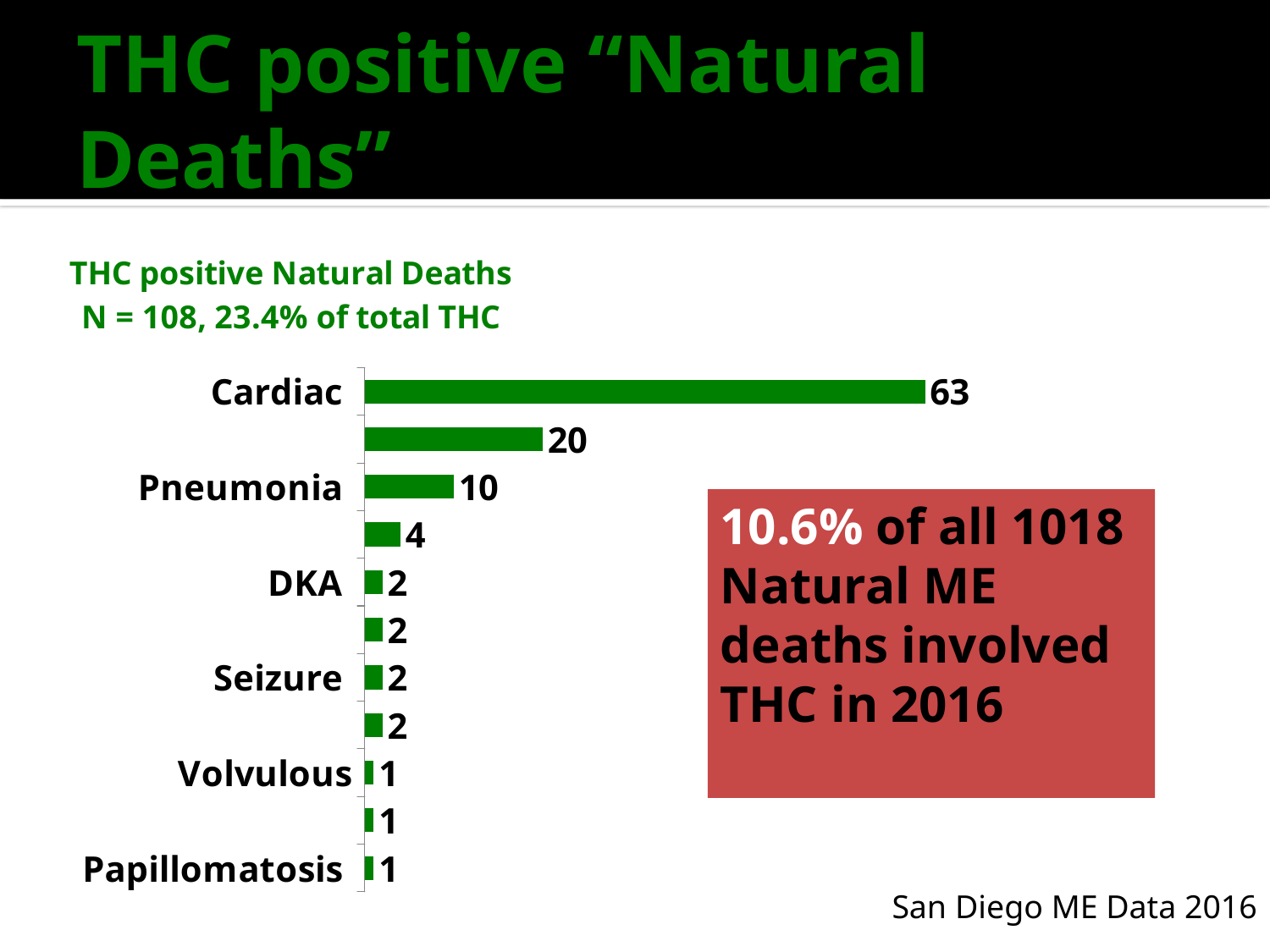
What is the title of the chart? THC positive Natural Deaths N = 108, 23.4% of total THC Which is larger, the value for Pneumonia or the value for DKA? Pneumonia What is the value for Seizure? 2 How many bars are plotted in the chart? 11 What is the difference between the values for Cardiac and Pneumonia? 53 What kind of chart is shown on the slide? Bar chart What is the value for Volvulous? 1 What is the value for DKA? 2 What is the value for Papillomatosis? 1 Which category has the highest value? Cardiac What is the value for Pneumonia? 10 What is the value for Cardiac? 63